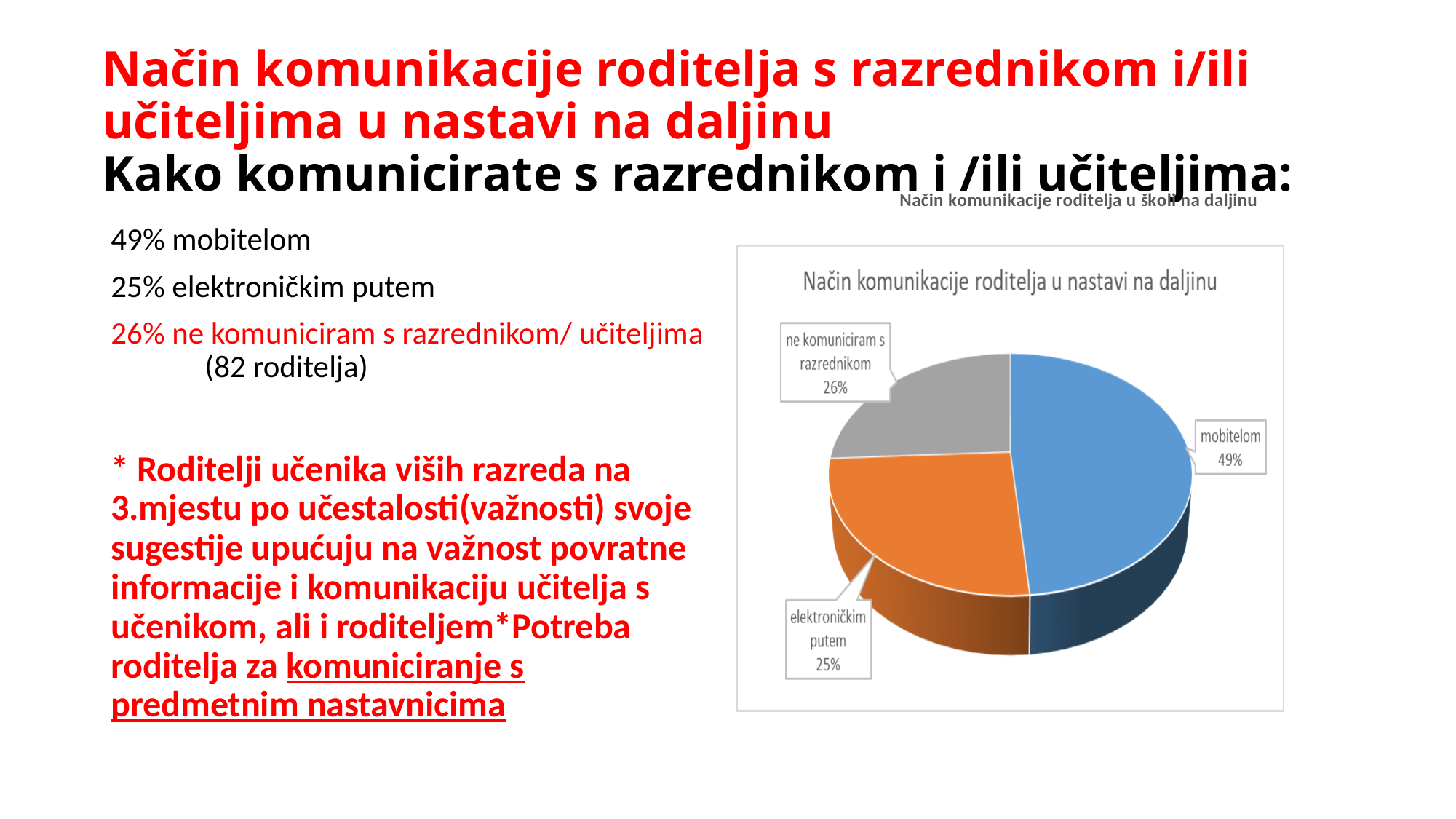
What percentage of the pie is labelled "elektroničkim putem"? 25% How many slices does the pie chart have? 3 What percentage of the pie is labelled "ne komuniciram s razrednikom"? 26% What is the difference in percentage points between the "mobitelom" slice and the "elektroničkim putem" slice? 24 What is the difference in percentage points between the "ne komuniciram s razrednikom" slice and the "elektroničkim putem" slice? 1 Which slice of the pie chart is the largest? mobitelom What type of chart is shown on the slide? pie chart What colour is the "mobitelom" slice in the pie chart? blue Which is larger: the "mobitelom" slice or the "ne komuniciram s razrednikom" slice? mobitelom What percentage of the pie is labelled "mobitelom"? 49% Which slice of the pie chart is the smallest? elektroničkim putem What is the title of the chart? Način komunikacije roditelja u nastavi na daljinu